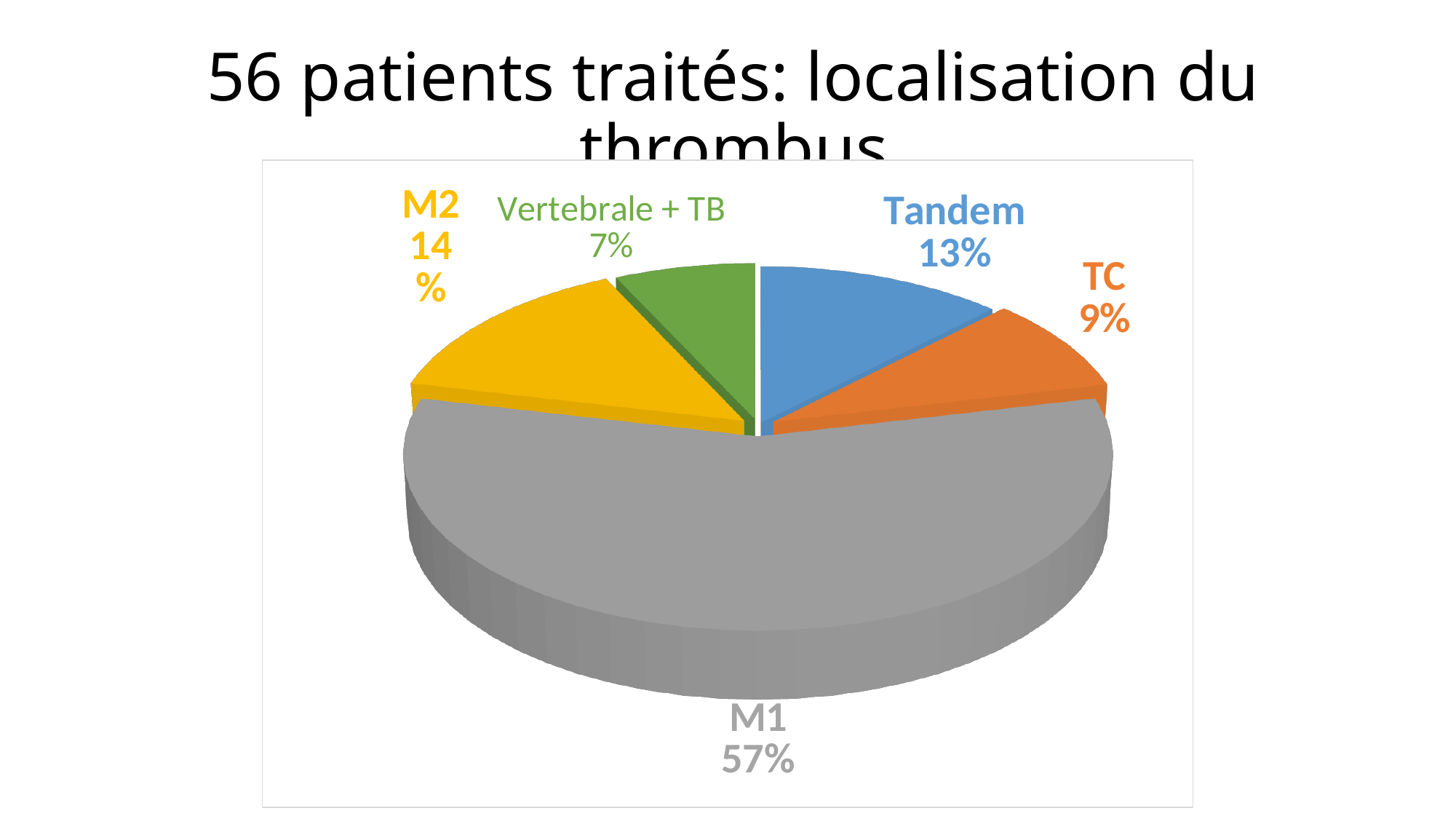
What percentage is shown for Vertebrale + TB? 7% What percentage is shown for Tandem? 13% What is the difference in percentage points between M1 and M2? 43 What percentage is shown for M2? 14% Which is larger, the share for Tandem or the share for TC? Tandem Which category has the smallest slice of the pie? Vertebrale + TB What share of the pie does M1 represent? 57% What percentage is shown for TC? 9% What kind of chart is shown on the slide? Pie chart How many categories are shown in the pie chart? 5 Which category has the largest slice of the pie? M1 What colour is the M1 slice? Grey